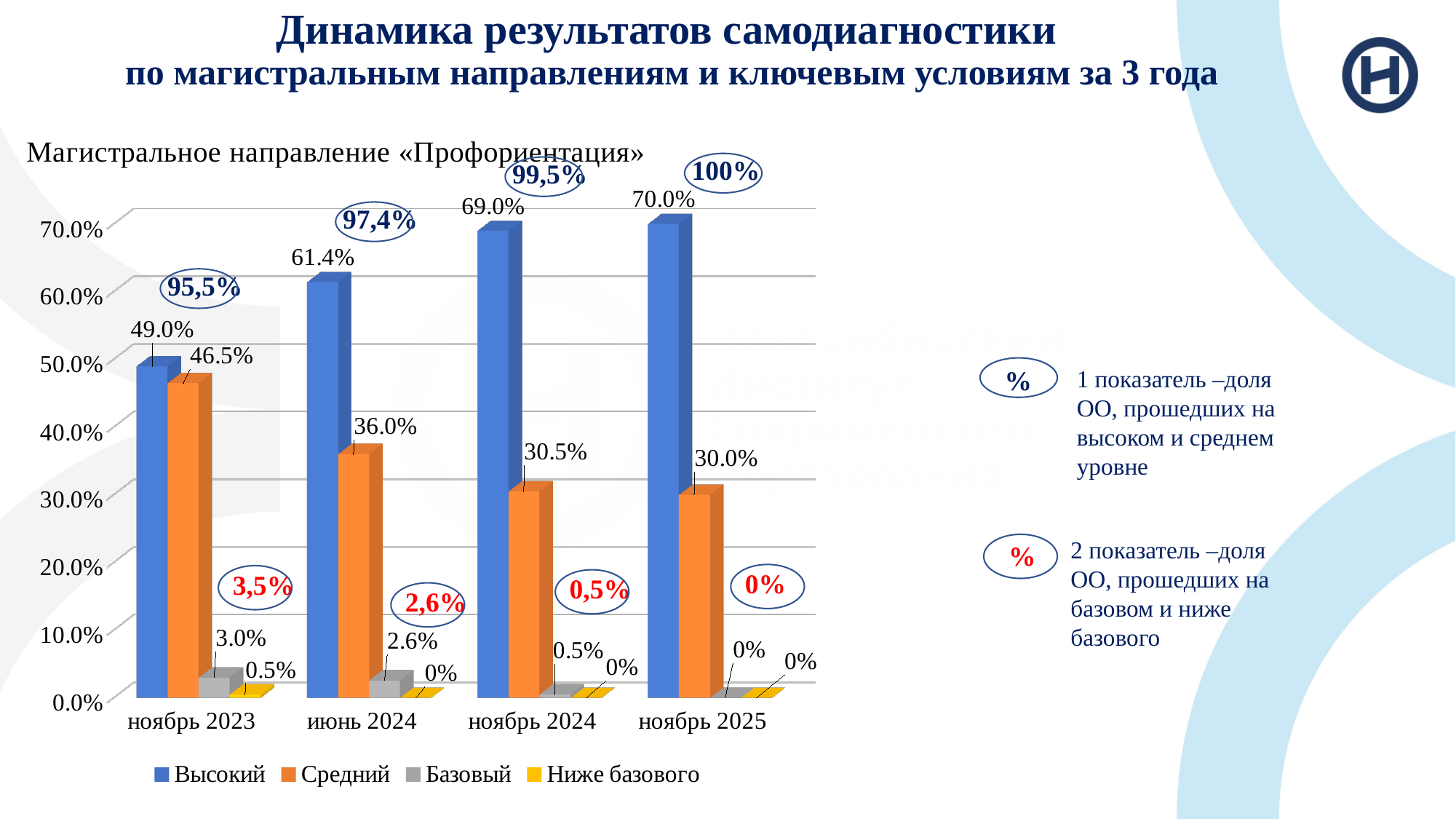
What kind of chart is shown on the slide? Bar chart What is the difference between the Высокий values for ноябрь 2025 and ноябрь 2023? 21.0% Which is larger in ноябрь 2023: Высокий or Средний? Высокий In which period is the Высокий series highest? ноябрь 2025 How many periods are shown on the x axis? 4 What is the value for Базовый in ноябрь 2024? 0.5% What is the value for Средний in июнь 2024? 36.0% In which period is the Средний series lowest? ноябрь 2025 What is the value for Высокий in ноябрь 2023? 49.0% How many series does the legend list? 4 Does the Высокий series rise or fall from ноябрь 2023 to ноябрь 2025? Rise What is the value for Ниже базового in ноябрь 2023? 0.5%